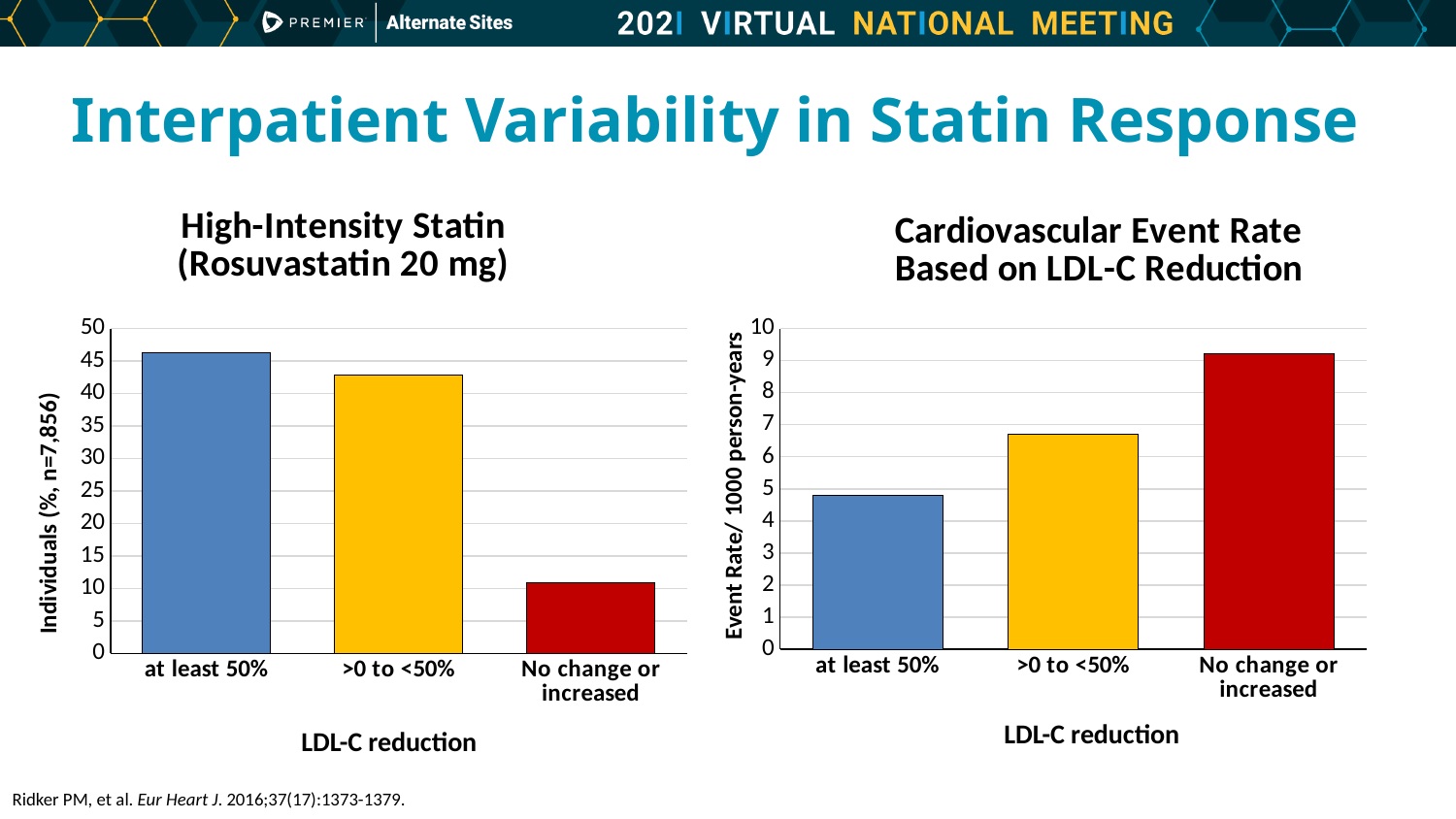
What is the y-axis label of the 'Cardiovascular Event Rate Based on LDL-C Reduction' chart? Event Rate/ 1000 person-years In the 'Cardiovascular Event Rate Based on LDL-C Reduction' chart, do the event rates rise or fall moving from 'at least 50%' to 'No change or increased'? rise In the 'Cardiovascular Event Rate Based on LDL-C Reduction' chart, is the event rate for '>0 to <50%' greater or less than 6? greater What kind of chart is the 'High-Intensity Statin (Rosuvastatin 20 mg)' chart? bar chart In the 'High-Intensity Statin (Rosuvastatin 20 mg)' chart, is the value for 'No change or increased' greater or less than 15? less How many LDL-C reduction categories are shown in the 'High-Intensity Statin (Rosuvastatin 20 mg)' chart? 3 In the 'Cardiovascular Event Rate Based on LDL-C Reduction' chart, which LDL-C reduction category has the lowest event rate? at least 50% In the 'Cardiovascular Event Rate Based on LDL-C Reduction' chart, is the event rate for 'at least 50%' greater or less than 5? less In the 'High-Intensity Statin (Rosuvastatin 20 mg)' chart, which LDL-C reduction category has the lowest percentage of individuals? No change or increased In the 'High-Intensity Statin (Rosuvastatin 20 mg)' chart, which LDL-C reduction category has the highest percentage of individuals? at least 50% In the 'Cardiovascular Event Rate Based on LDL-C Reduction' chart, which LDL-C reduction category has the highest event rate? No change or increased